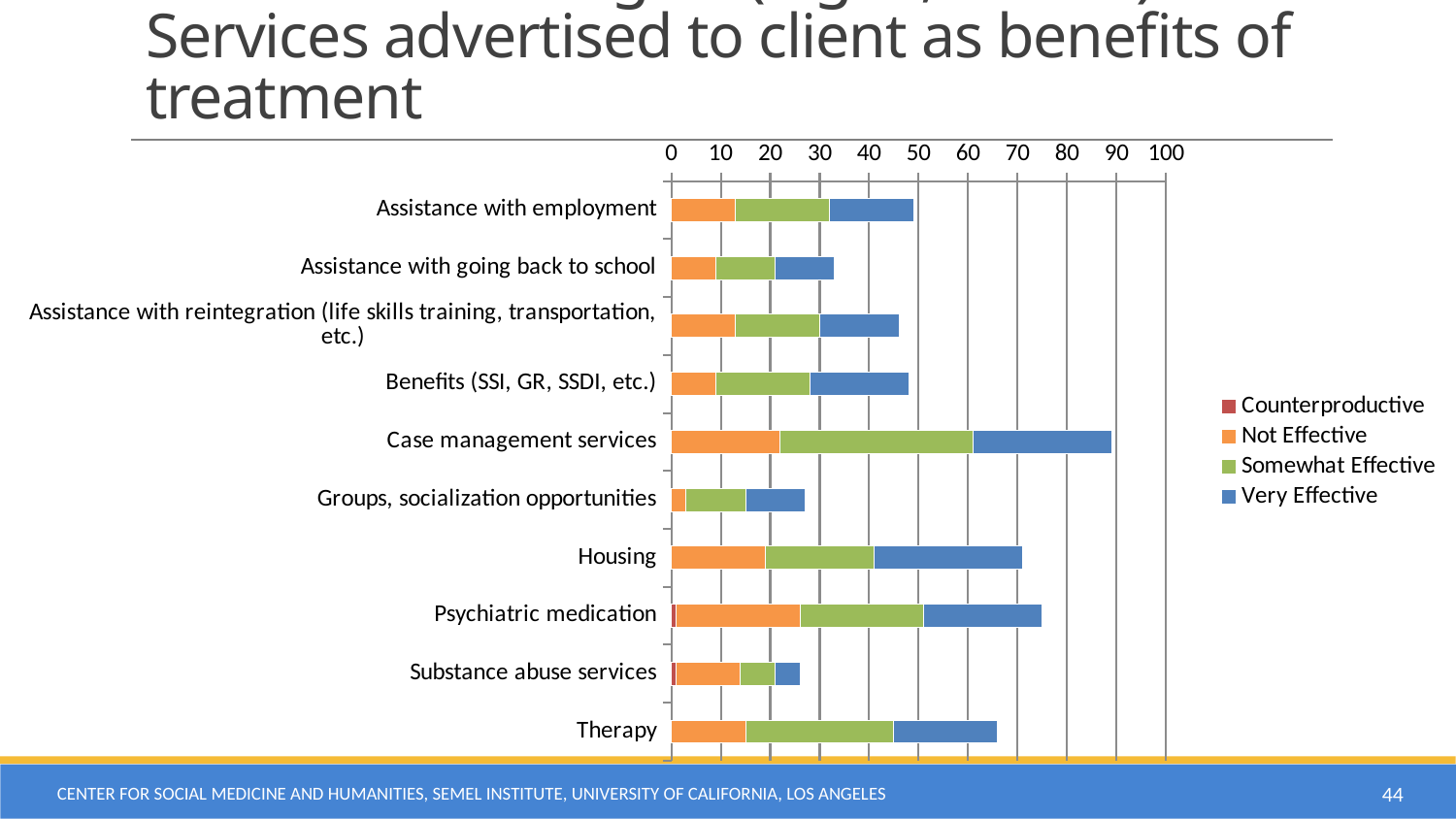
How many series does the legend list? 4 Is the total bar for Groups, socialization opportunities greater or less than 30? less Is the total bar for Case management services greater or less than 80? greater Which has the longer total bar, Psychiatric medication or Benefits (SSI, GR, SSDI, etc.)? Psychiatric medication Which legend entry is shown in orange? Not Effective Is the total bar for Therapy greater or less than 60? greater What kind of chart is shown on the slide? Bar chart Which service category has the longest total bar? Case management services Which has the longer total bar, Housing or Assistance with employment? Housing How many service categories are plotted on the chart? 10 Which legend entry is shown in blue? Very Effective